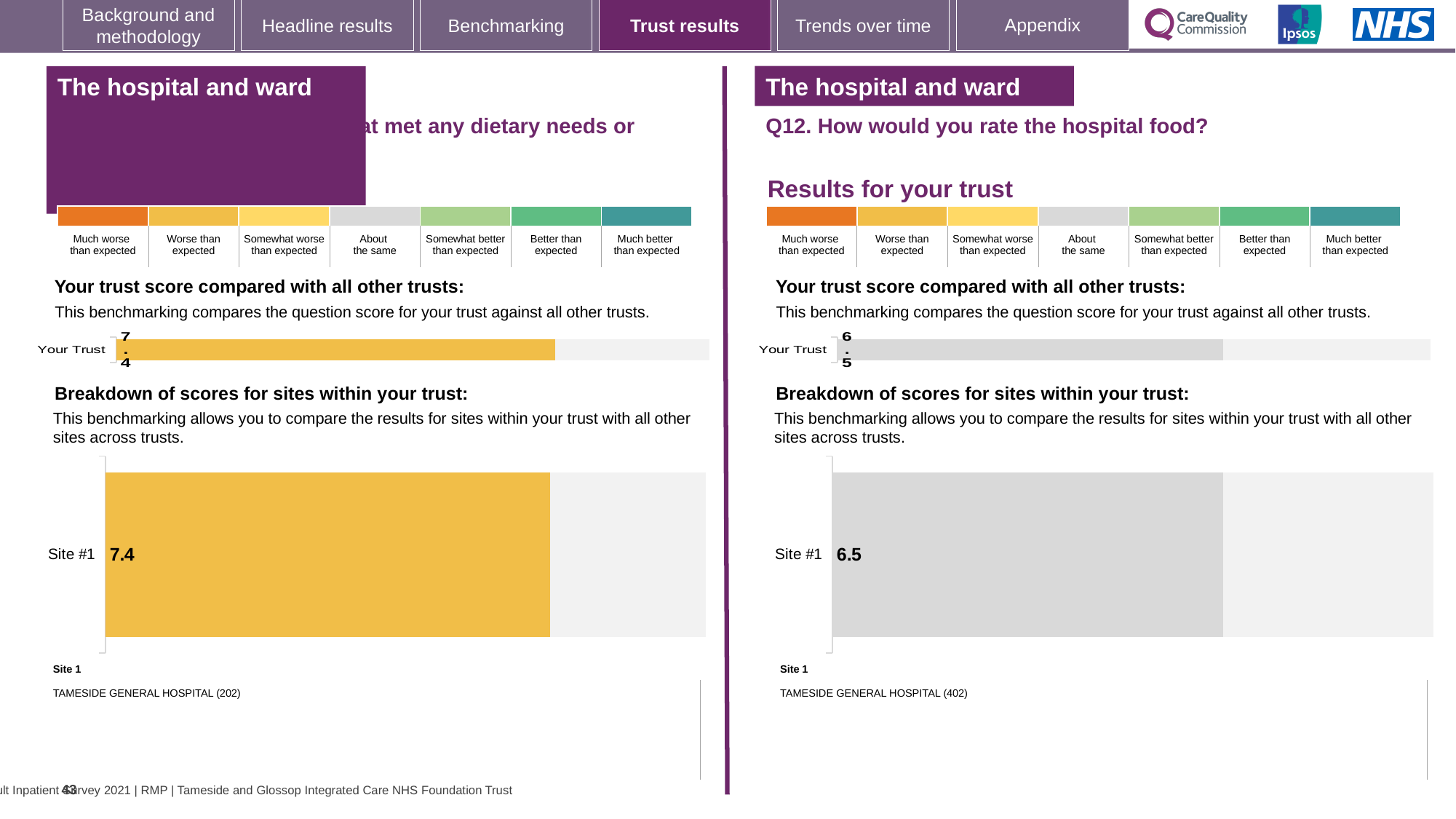
According to the colour key, which benchmark category does the grey colour of the Site #1 bar on the right-hand side of the slide (Q12) represent? About the same Which site name is listed as Site 1 beneath the breakdown chart on the right-hand side of the slide (Q12)? TAMESIDE GENERAL HOSPITAL (402) On the right-hand side of the slide (Q12. How would you rate the hospital food?), what is the score shown for Site #1 in the breakdown of scores for sites within your trust? 6.5 What kind of chart is used to show the breakdown of scores for sites within your trust on the right-hand side of the slide (Q12)? Bar chart Is the Site #1 score on the left-hand side of the slide the same as the Your Trust score on that side? Yes, both are 7.4 Which Site #1 score is larger: the one on the left-hand side of the slide or the one on the right-hand side (Q12)? The left-hand side (7.4) On the left-hand side of the slide, what is the score shown for Site #1 in the breakdown of scores for sites within your trust? 7.4 What is the difference between the Site #1 score on the left-hand side of the slide and the Site #1 score on the right-hand side (Q12)? 0.9 On the right-hand side of the slide (Q12), what is the value shown for Your Trust in the chart comparing your trust score with all other trusts? 6.5 How many sites are shown in the breakdown of scores for sites within your trust on the left-hand side of the slide? 1 On the left-hand side of the slide, what is the value shown for Your Trust in the chart comparing your trust score with all other trusts? 7.4 How many sites are shown in the breakdown of scores for sites within your trust on the right-hand side of the slide (Q12)? 1